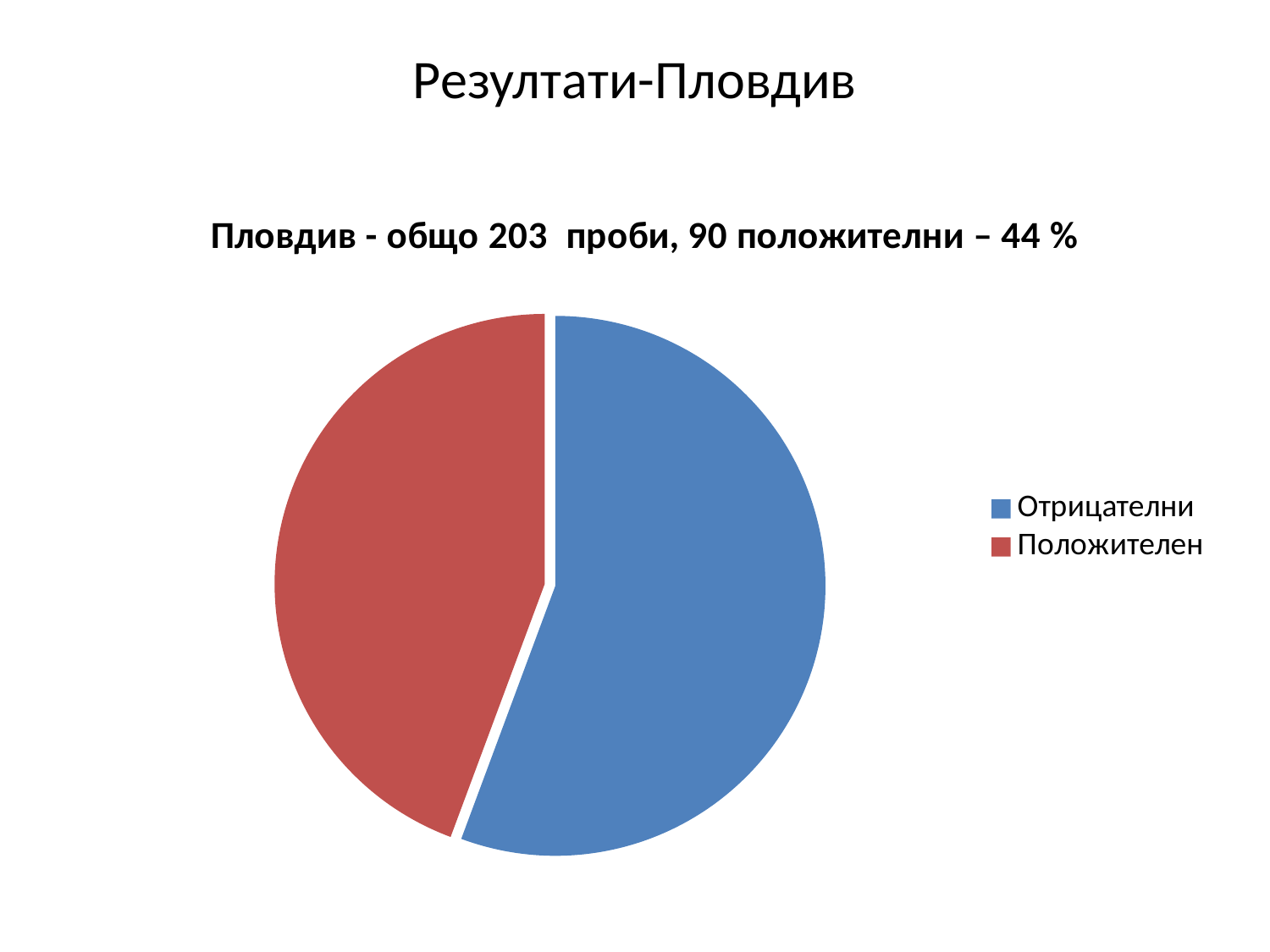
How many entries does the legend of the pie chart list? 2 According to the chart title, how many samples (проби) were tested in total in Пловдив? 203 According to the chart title, what share of the samples were positive (положителни)? 44 % What is the title of the pie chart? Пловдив - общо 203 проби, 90 положителни – 44 % According to the chart title, how many samples were positive (положителни)? 90 What kind of chart is shown on the slide? pie chart Which slice of the pie chart is the largest? Отрицателни Which slice of the pie chart is the smallest? Положителен What colour represents Отрицателни in the pie chart? blue How many slices does the pie chart have? 2 Which slice is larger, Отрицателни or Положителен? Отрицателни